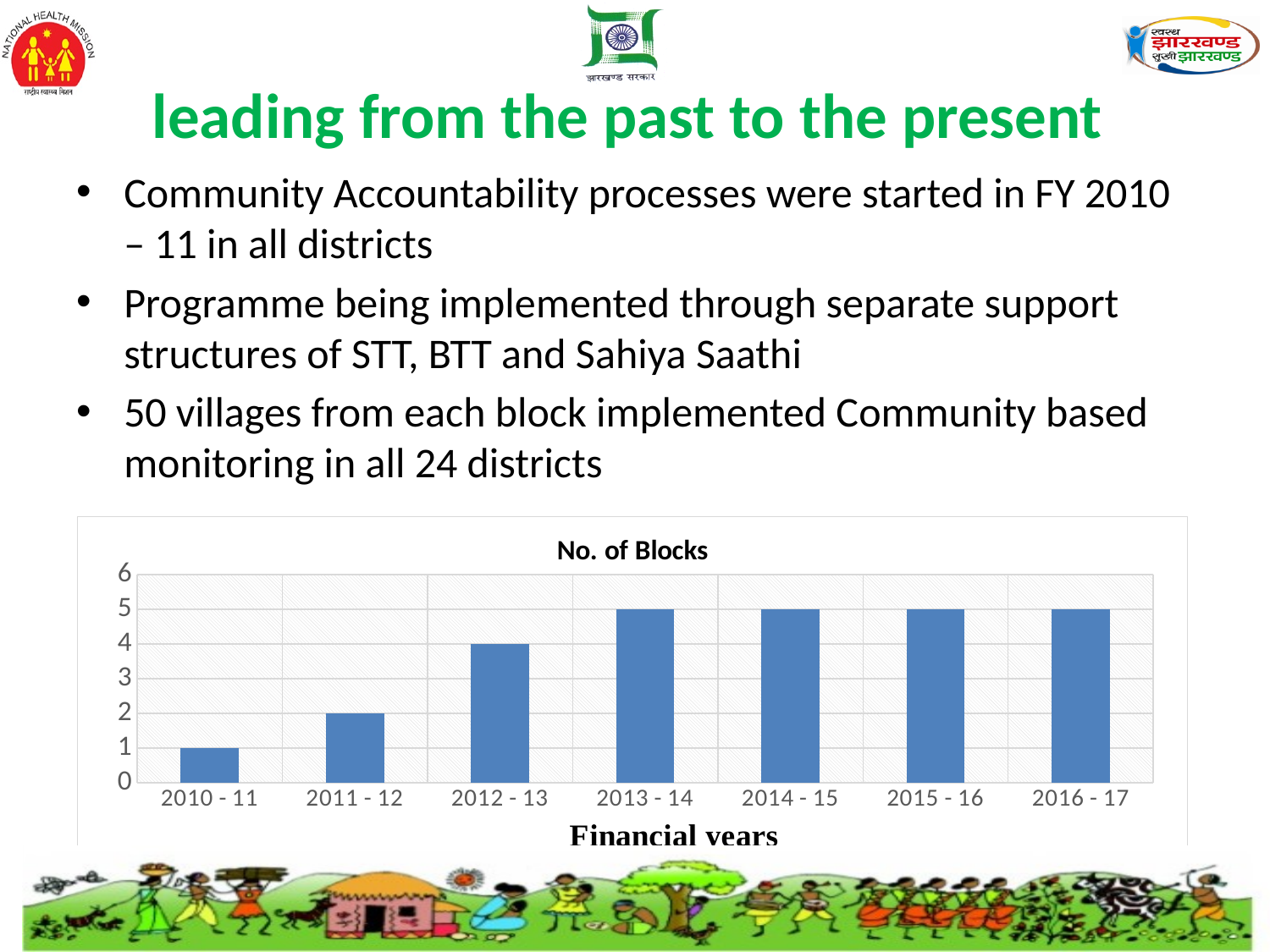
What is the number of blocks for 2010 - 11? 1 Which has more blocks, 2012 - 13 or 2011 - 12? 2012 - 13 What is the number of blocks for 2011 - 12? 2 What is the difference in the number of blocks between 2012 - 13 and 2011 - 12? 2 What is the label of the x axis of the chart? Financial years How many financial years are shown on the x axis of the chart? 7 What is the title of the chart? No. of Blocks Which financial year has the lowest number of blocks? 2010 - 11 What type of chart is shown on the slide? bar chart Do the number of blocks generally rise or fall from 2010 - 11 to 2016 - 17? rise What is the number of blocks for 2012 - 13? 4 What is the number of blocks for 2016 - 17? 5